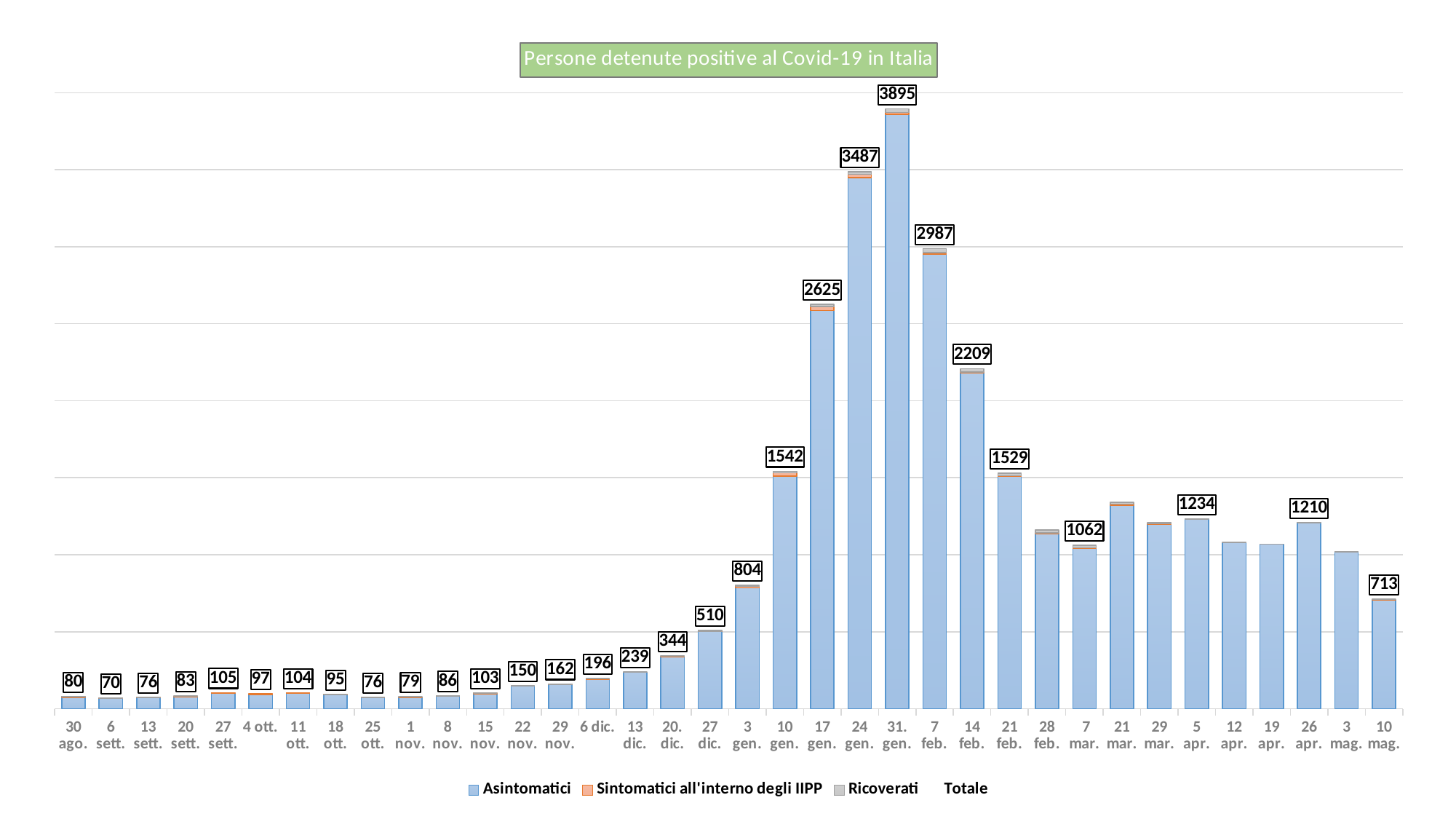
What kind of chart is this? Stacked bar chart What is the title of the chart? Persone detenute positive al Covid-19 in Italia Which date has the highest total? 31. gen. What is the total value shown for 3 gen.? 804 How many dates are shown on the x axis? 36 What is the total value shown for 31. gen.? 3895 How many entries does the legend list? 4 What is the total value shown for 10 mag.? 713 Which date has the lowest total? 6 sett. Which has a larger total, 24 gen. or 7 feb.? 24 gen. What is the difference between the totals for 31. gen. and 24 gen.? 408 Do the totals rise or fall from 31. gen. to 21 feb.? Fall